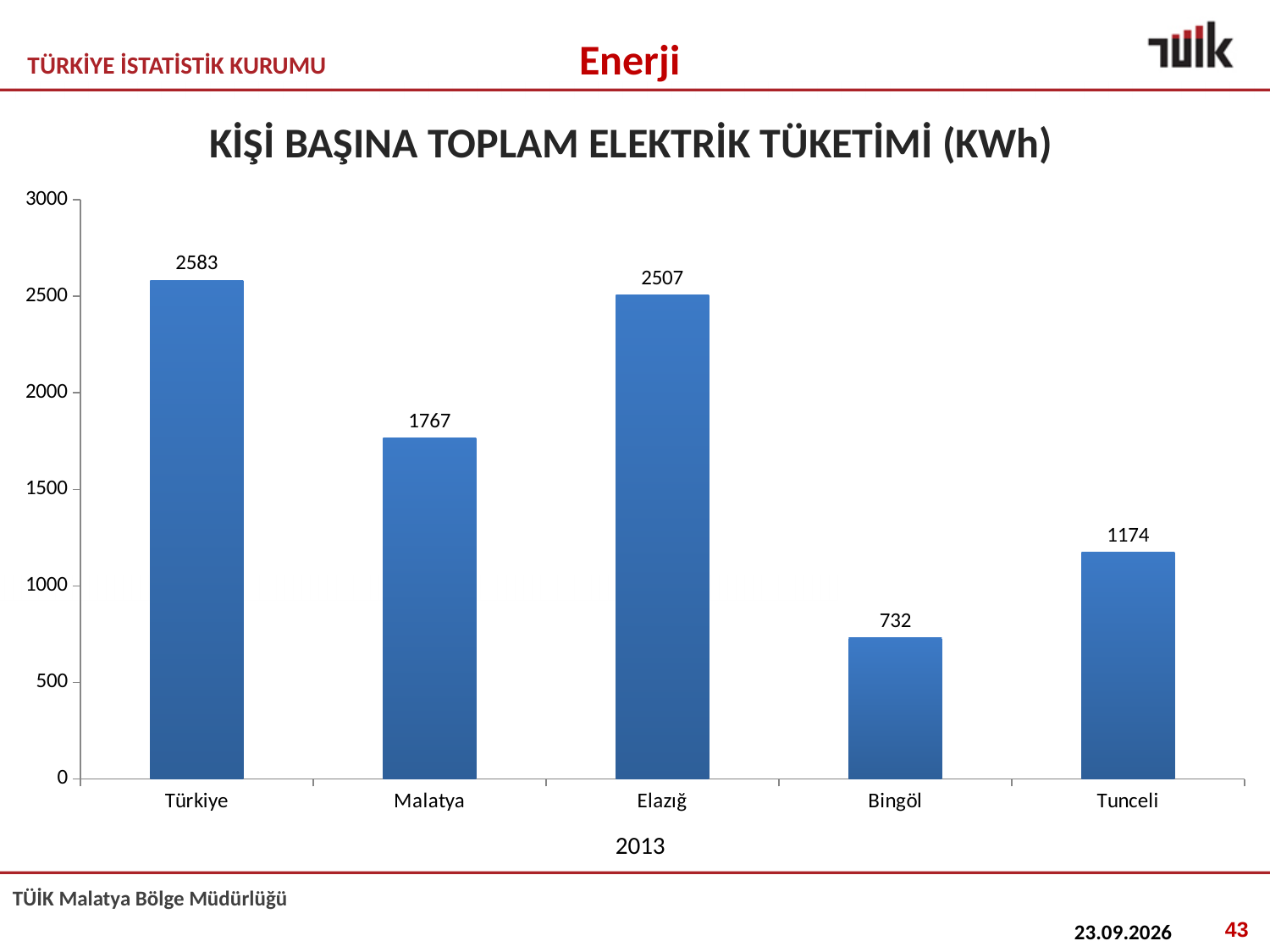
What value is shown for Tunceli? 1174 Which category has the highest value? Türkiye Which is larger, the value for Malatya or the value for Tunceli? Malatya What value is shown for Bingöl? 732 What is the per capita total electricity consumption value shown for Malatya? 1767 Which category has the lowest value? Bingöl How many categories are shown on the x axis? 5 What year is shown below the category labels on the x axis? 2013 What is the difference between the values for Malatya and Tunceli? 593 What is the difference between the values for Türkiye and Elazığ? 76 What kind of chart is shown on the slide? bar chart Is the value for Elazığ greater or less than 2000? greater